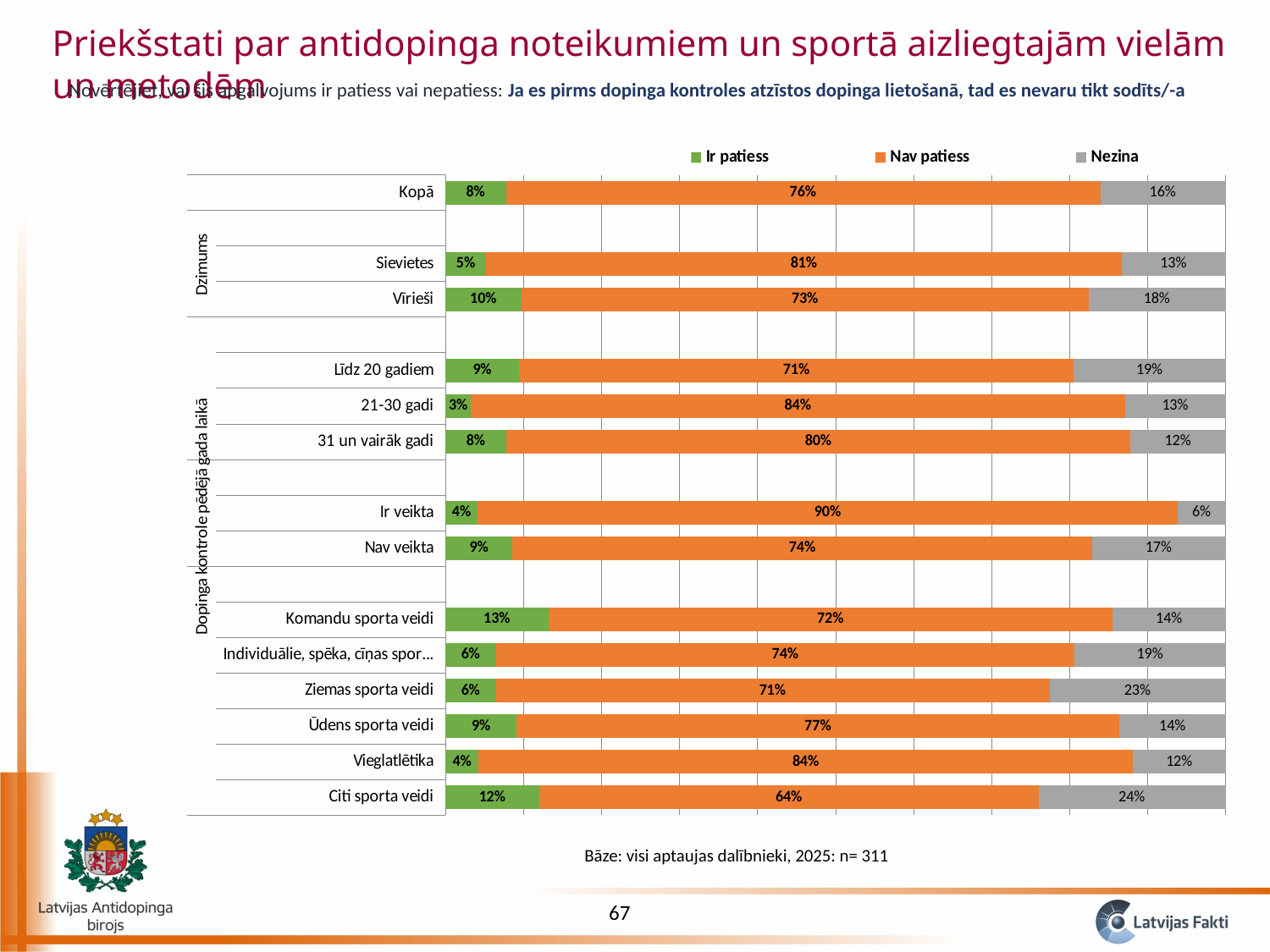
What kind of chart is shown on the slide? Stacked bar chart What percentage of Kopā respondents answered Nav patiess? 76% Which category has the highest Nav patiess value? Ir veikta What is the Nezina value for Ziemas sporta veidi? 23% Which category has the highest Nezina value? Citi sporta veidi Which has a larger Ir patiess value, Vīrieši or Sievietes? Vīrieši What is the difference between the Nav patiess values for Sievietes and Vīrieši? 8% What is the total of the stacked bar for Kopā? 100% How many series does the legend list? 3 What is the Ir patiess value for Komandu sporta veidi? 13% Which category has the lowest Nav patiess value? Citi sporta veidi How many categories are shown in the chart? 14